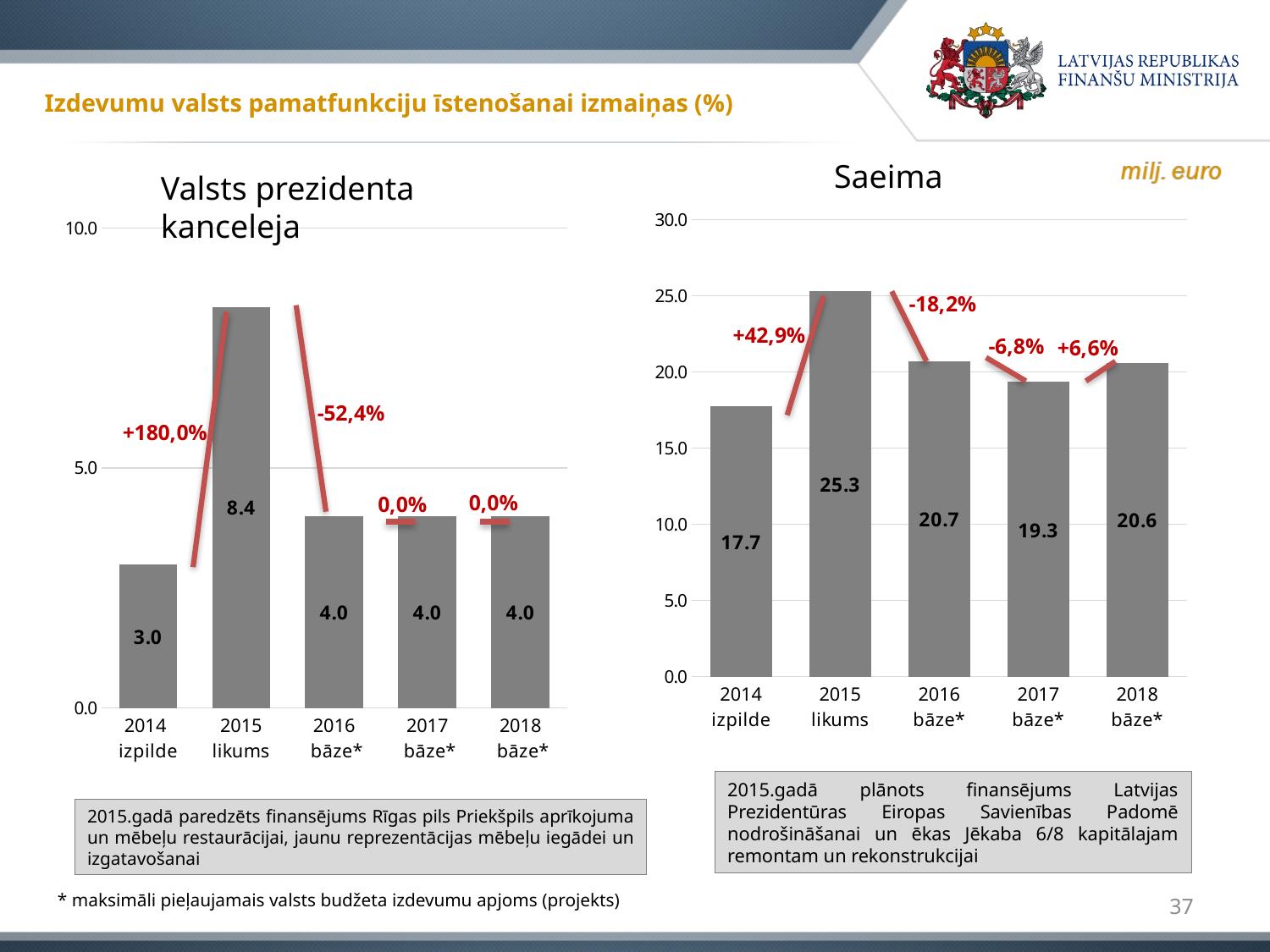
In the 'Saeima' chart, what is the difference between the 2015 likums value and the 2014 izpilde value? 7.6 In the 'Valsts prezidenta kanceleja' chart, what is the value for 2015 likums? 8.4 In the 'Valsts prezidenta kanceleja' chart, how many bars are plotted? 5 What unit is indicated for the values in the charts on the slide? milj. euro In the 'Saeima' chart, which is larger, the value for 2016 bāze* or the value for 2018 bāze*? 2016 bāze* What kind of chart is the 'Saeima' chart? Bar chart In the 'Valsts prezidenta kanceleja' chart, what percentage change is shown between 2014 izpilde and 2015 likums? +180,0% In the 'Saeima' chart, what percentage change is shown between 2015 likums and 2016 bāze*? -18,2% In the 'Saeima' chart, what is the value for 2017 bāze*? 19.3 In the 'Valsts prezidenta kanceleja' chart, what is the difference between the 2015 likums value and the 2016 bāze* value? 4.4 In the 'Valsts prezidenta kanceleja' chart, which category has the lowest value? 2014 izpilde In the 'Saeima' chart, which category has the highest value? 2015 likums